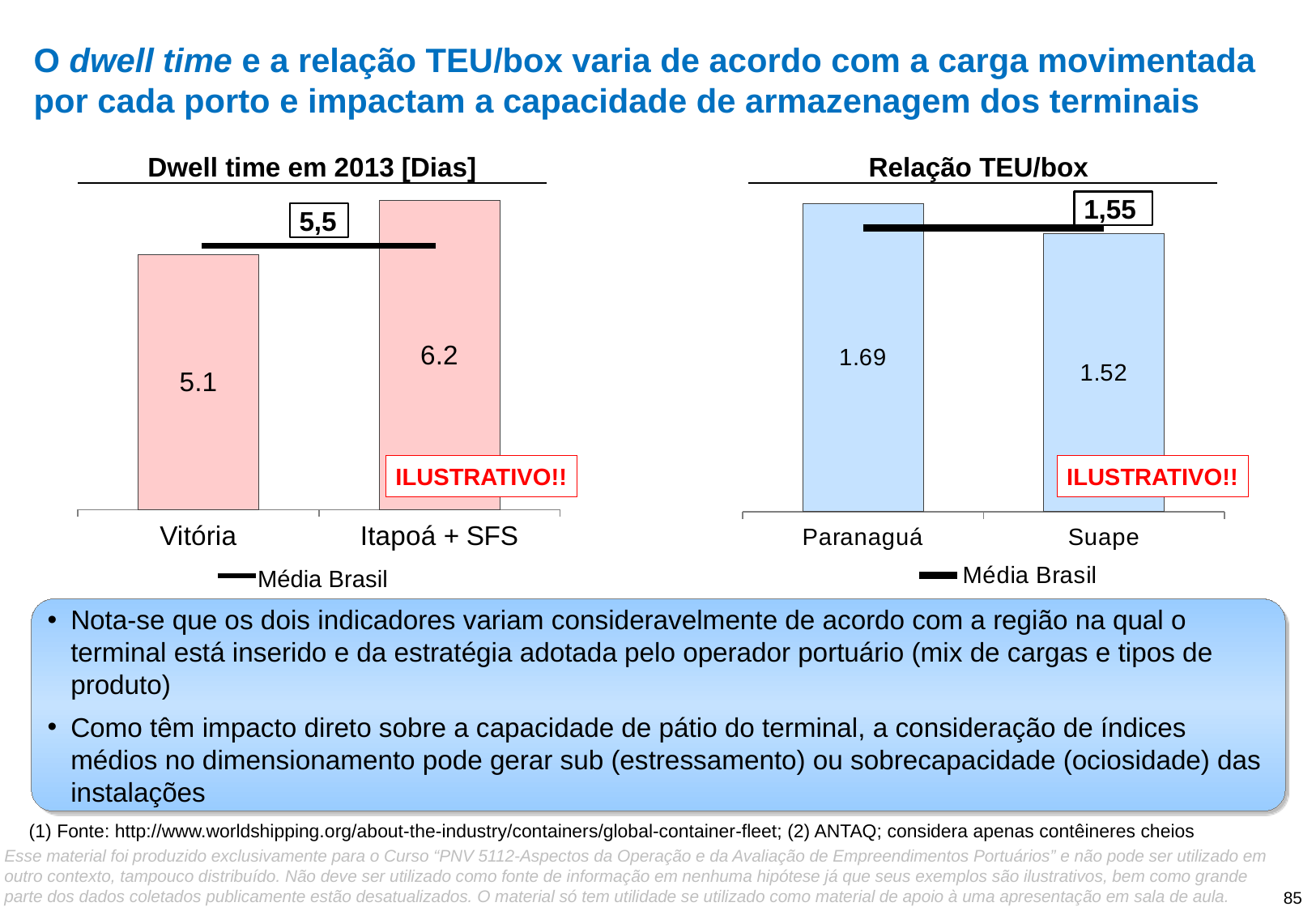
In the 'Relação TEU/box' chart, what is the value for Paranaguá? 1.69 In the 'Relação TEU/box' chart, what is the value of the Média Brasil line? 1,55 In the 'Relação TEU/box' chart, which category has the lowest value? Suape In the 'Dwell time em 2013 [Dias]' chart, what is the value for Vitória? 5.1 In the 'Dwell time em 2013 [Dias]' chart, what is the value of the Média Brasil line? 5,5 In the 'Relação TEU/box' chart, what is the value for Suape? 1.52 What kind of chart is the 'Dwell time em 2013 [Dias]' chart? Bar chart In the 'Dwell time em 2013 [Dias]' chart, what is the value for Itapoá + SFS? 6.2 In the 'Relação TEU/box' chart, what is the difference between Paranaguá and Suape? 0.17 In the 'Dwell time em 2013 [Dias]' chart, which category has the highest value? Itapoá + SFS In the 'Dwell time em 2013 [Dias]' chart, what is the difference between Itapoá + SFS and Vitória? 1.1 In the 'Relação TEU/box' chart, how many categories are shown on the x axis? 2